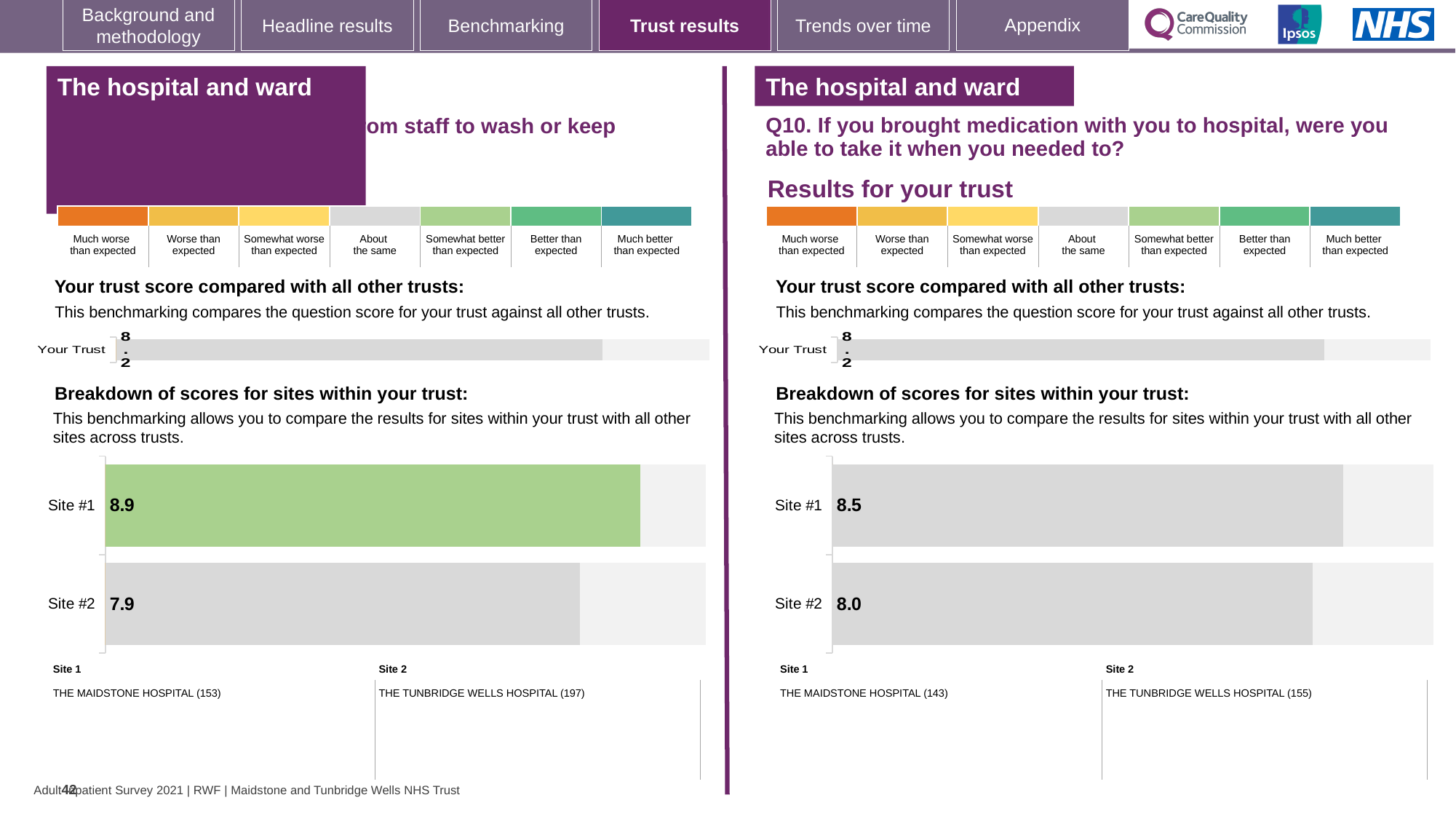
On the right-hand (Q10 medication) site breakdown chart, what is the score for Site #2? 8.0 On the right-hand (Q10 medication) site breakdown chart, what is the score for Site #1? 8.5 On the right-hand (Q10 medication) 'Your trust score compared with all other trusts' chart, what is the score shown for Your Trust? 8.2 On the right-hand (Q10 medication) site breakdown chart, what is the difference between the Site #1 and Site #2 scores? 0.5 On the left-hand site breakdown chart, what is the score for Site #2? 7.9 On the left-hand site breakdown chart, what is the score for Site #1? 8.9 On the right-hand (Q10 medication) site breakdown chart, which site has the lower score? Site #2 How many sites are shown on the right-hand (Q10 medication) site breakdown chart? 2 On the left-hand 'Your trust score compared with all other trusts' chart, what is the score shown for Your Trust? 8.2 What kind of chart is the left-hand site breakdown chart? Bar chart On the left-hand site breakdown chart, what is the difference between the Site #1 and Site #2 scores? 1.0 On the left-hand site breakdown chart, which site has the higher score? Site #1